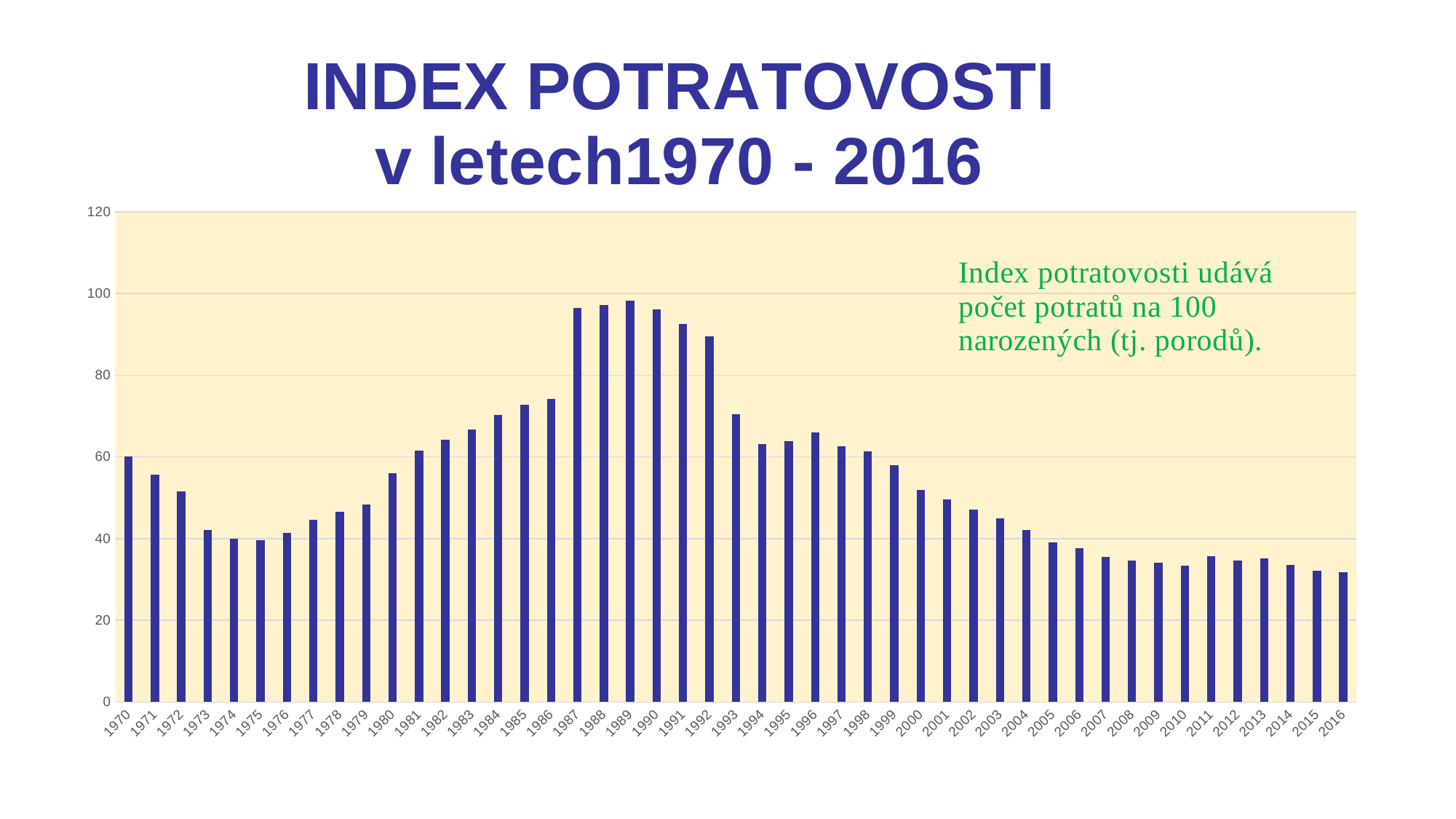
What kind of chart is shown on the slide? bar chart How many years (bars) are plotted on the chart? 47 Do the values rise or fall from 1992 to 2016? fall Is the value for 1989 greater or less than 80? greater Is the value for 2000 greater or less than 40? greater Is the value for 2016 greater or less than 40? less What is the title of the slide containing the chart? INDEX POTRATOVOSTI v letech1970 - 2016 Which year has the larger value, 1992 or 1993? 1992 Which year has the larger value, 1975 or 1985? 1985 Which year has the larger value, 1987 or 1970? 1987